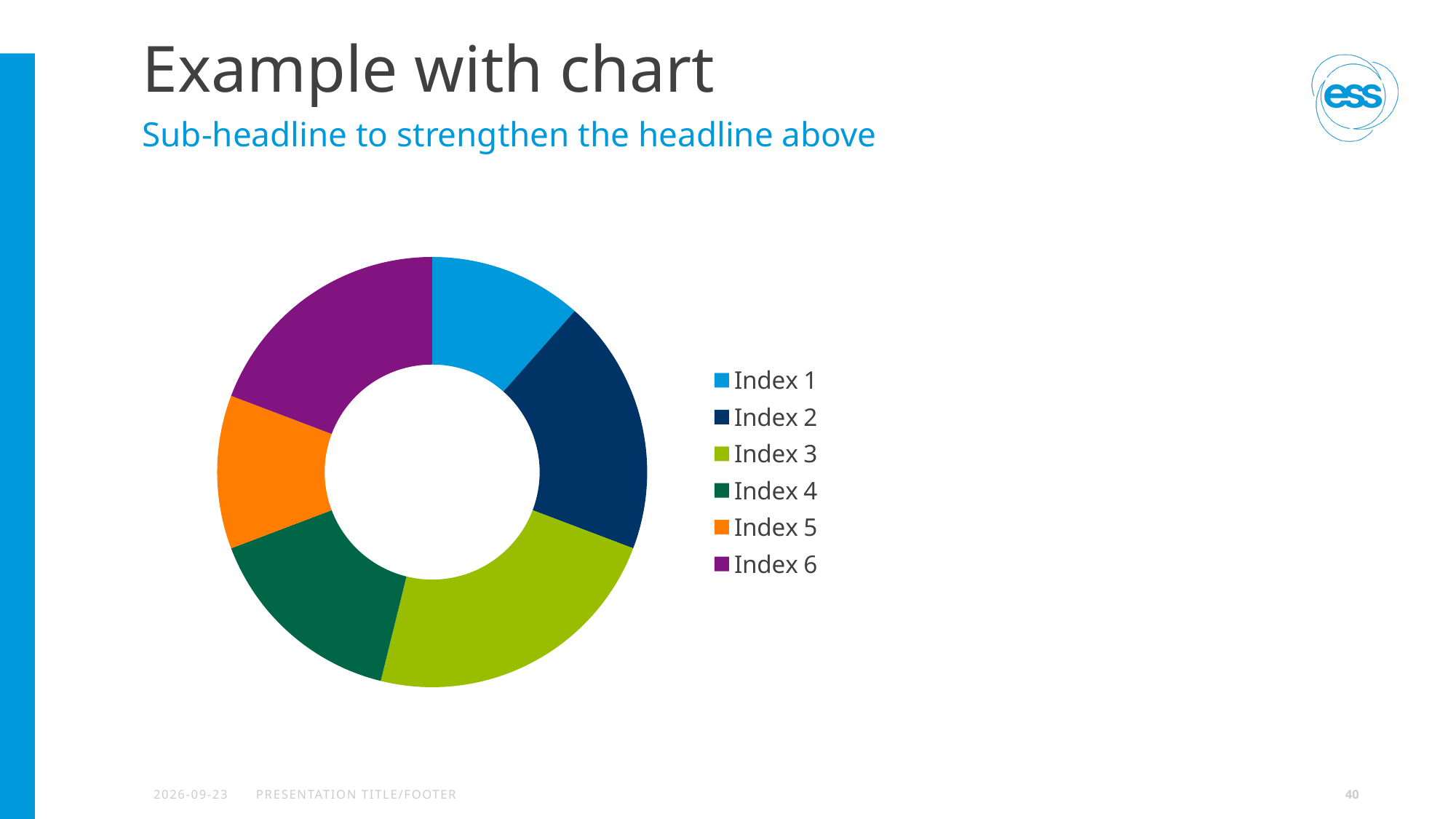
Which slice is larger, Index 3 or Index 1? Index 3 Which category has the largest slice in the chart? Index 3 How many categories (slices) does the chart have? 6 What is the label of the first entry in the legend? Index 1 How many entries does the chart's legend list? 6 Which slice is larger, Index 2 or Index 1? Index 2 Which slice is larger, Index 6 or Index 4? Index 6 What kind of chart is shown on the slide? doughnut chart What colour is the slice for Index 5? orange